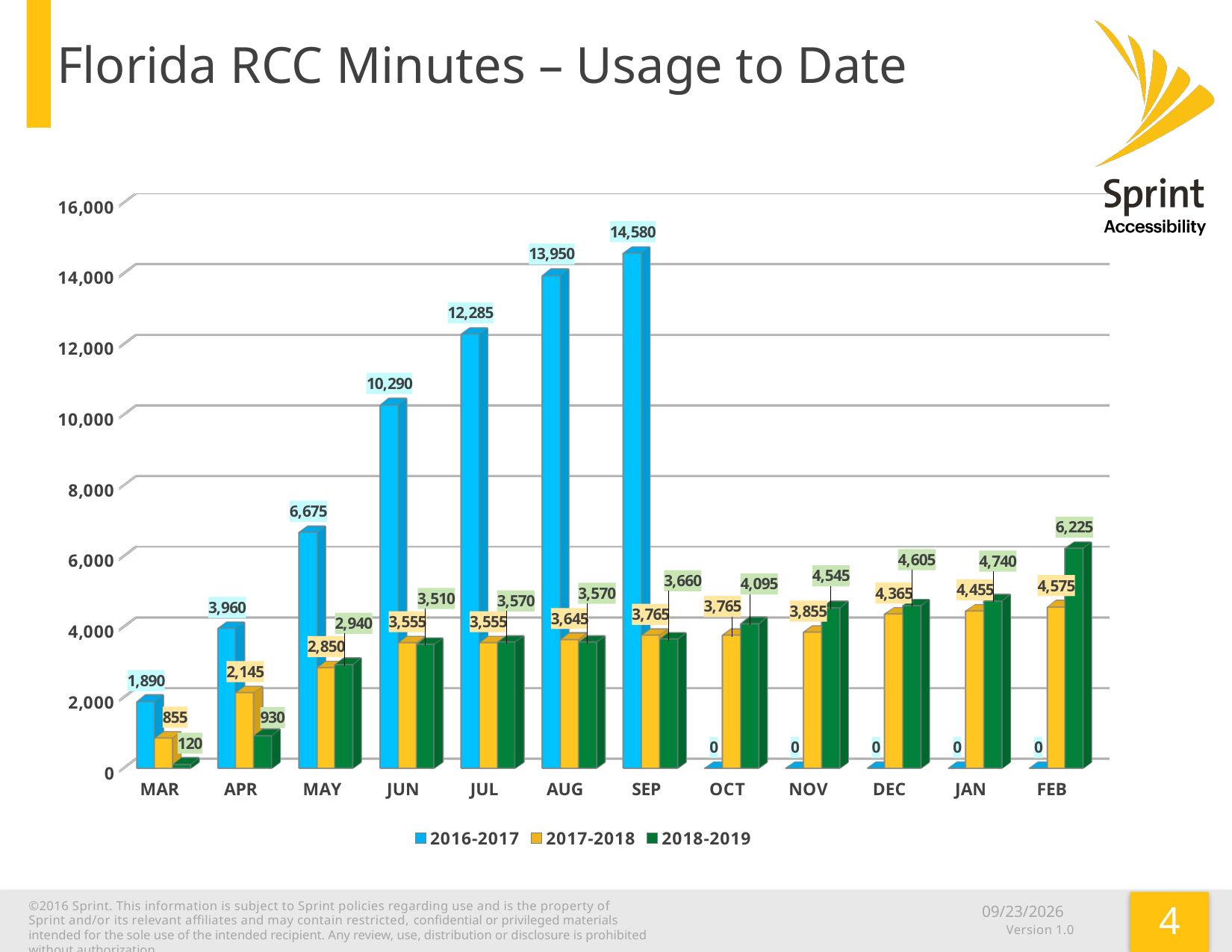
How many series does the legend list? 3 Is the value for 2016-2017 in AUG greater or less than 12,000? greater How many months are shown on the x axis? 12 What kind of chart is shown on the slide? Bar chart Which is larger in NOV: the 2017-2018 value or the 2018-2019 value? 2018-2019 What is the difference between the 2018-2019 and 2017-2018 values in FEB? 1,650 What is the value for 2018-2019 in FEB? 6,225 Do the 2018-2019 values rise or fall from OCT to FEB? Rise What is the value for 2016-2017 in SEP? 14,580 Which month has the lowest value for the 2018-2019 series? MAR Which month has the highest value for the 2016-2017 series? SEP What is the value for 2017-2018 in APR? 2,145